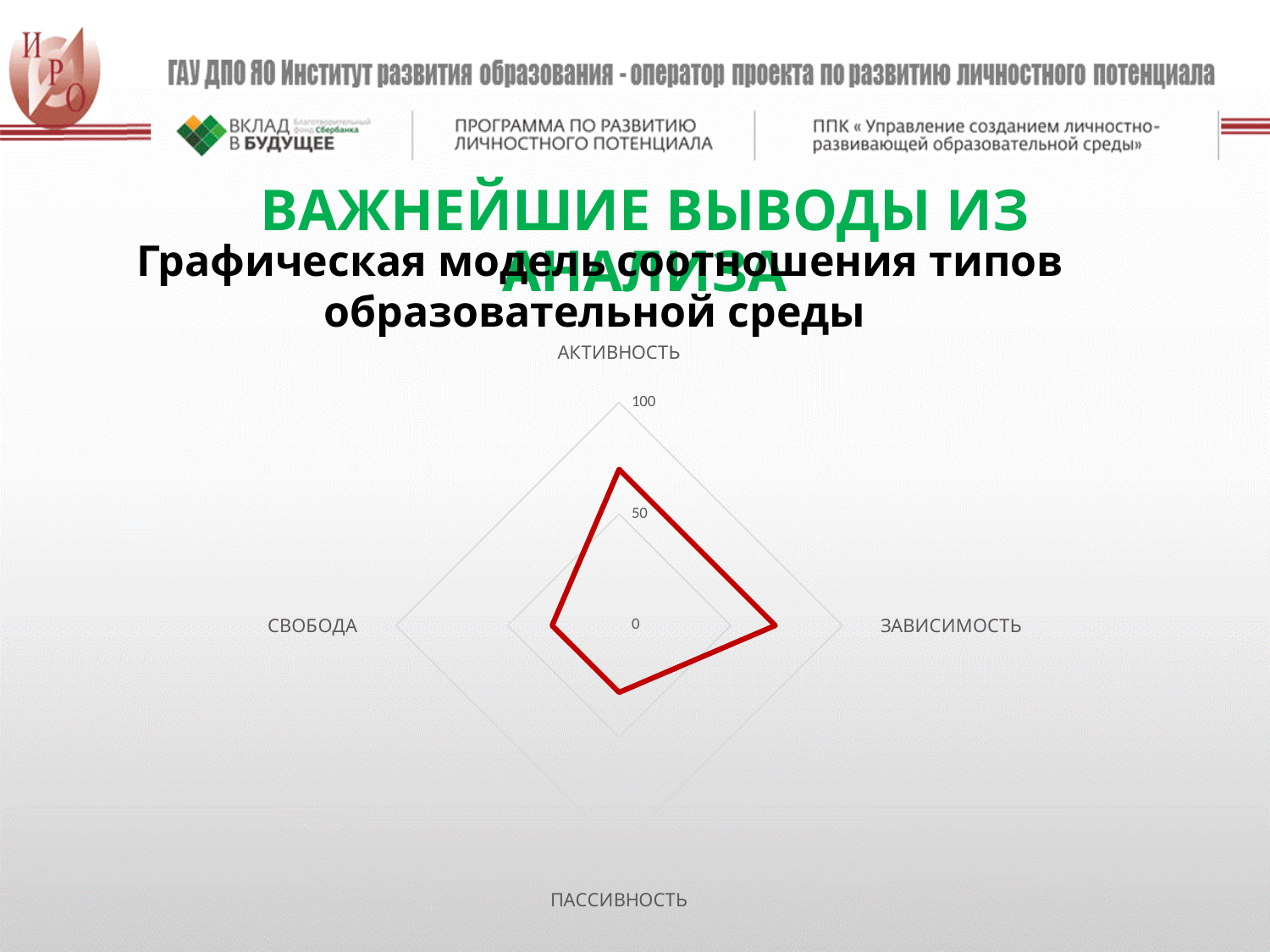
Is the value for СВОБОДА greater or less than 50? less Is the value for ПАССИВНОСТЬ greater or less than 50? less Which is larger, the value for ЗАВИСИМОСТЬ or the value for СВОБОДА? ЗАВИСИМОСТЬ Is the value for АКТИВНОСТЬ greater or less than 50? greater Which is larger, the value for АКТИВНОСТЬ or the value for ПАССИВНОСТЬ? АКТИВНОСТЬ Which category has the lowest value on the radar chart? ПАССИВНОСТЬ and СВОБОДА (tied) What kind of chart is shown on the slide? radar chart How many axes (categories) does the radar chart have? 4 Which category label appears at the bottom of the radar chart? ПАССИВНОСТЬ Which category has the highest value on the radar chart? АКТИВНОСТЬ and ЗАВИСИМОСТЬ (tied) What is the maximum value shown on the radar chart's scale? 100